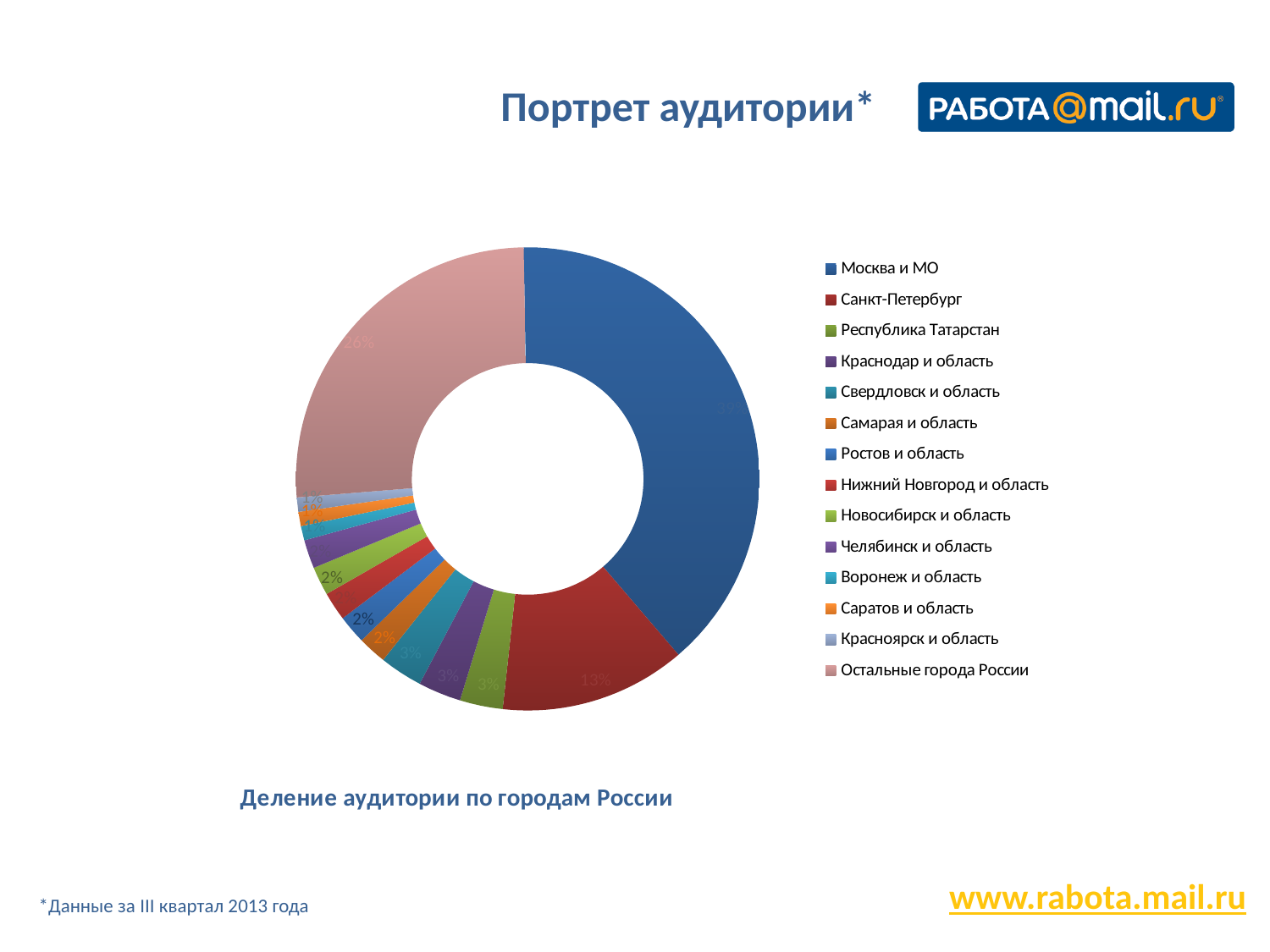
What is the caption of the chart? Деление аудитории по городам России What kind of chart is shown on the slide? Doughnut (pie) chart What share of the audience is from Санкт-Петербург? 13% How many categories does the legend of the chart list? 14 By how many percentage points does the share for Остальные города России exceed the share for Санкт-Петербург? 13 percentage points What share of the audience is from Республика Татарстан? 3% Which is larger: the share for Санкт-Петербург or the share for Остальные города России? Остальные города России Which category is listed first in the legend? Москва и МО What share of the audience is from Остальные города России? 26% How many data series does the chart plot? 1 What share of the audience is from Самарая и область? 2% Which category has the largest share of the audience? Москва и МО